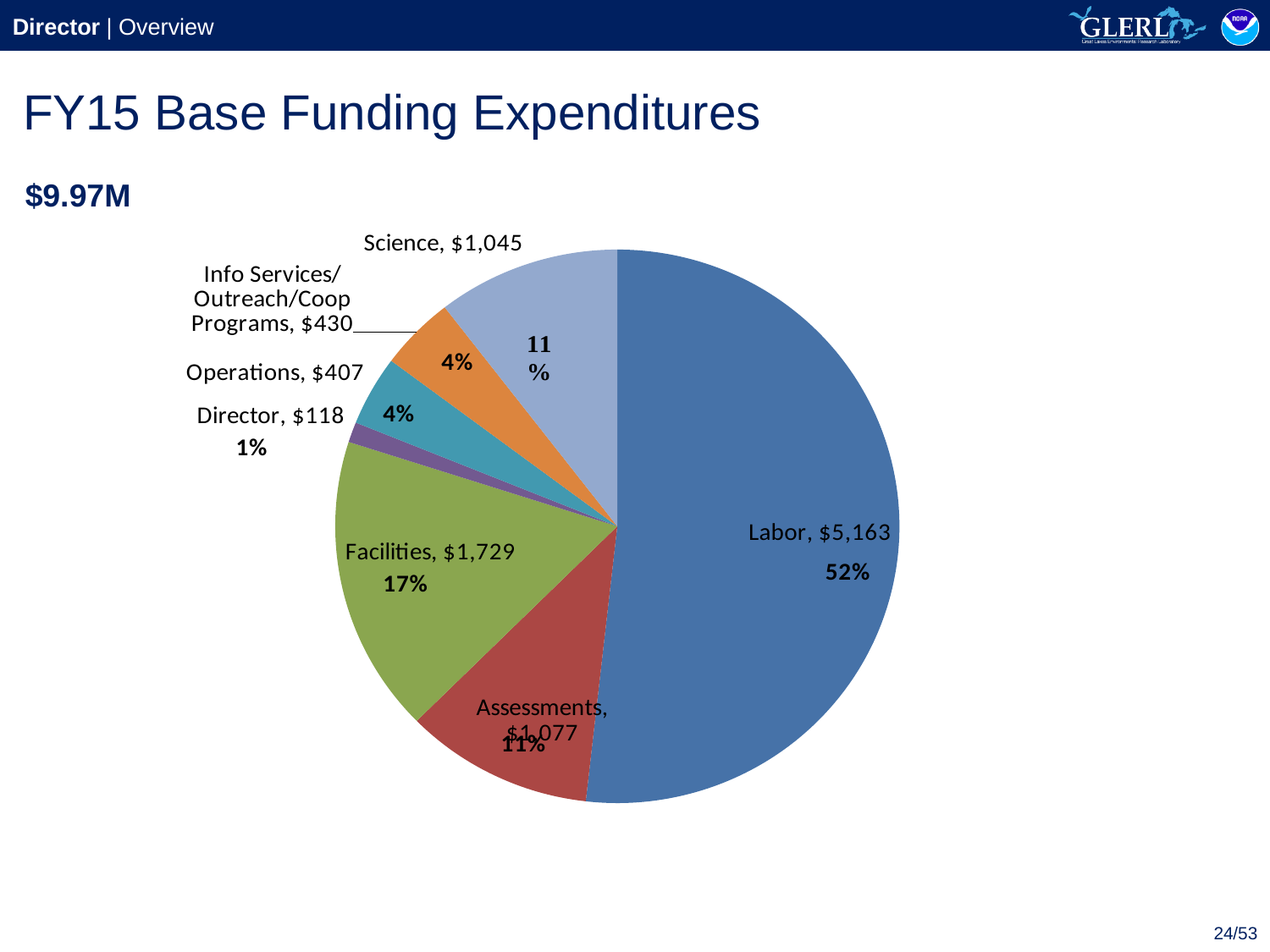
How many categories are shown in the pie chart? 7 Which is larger, the value for Operations or the value for Info Services/Outreach/Coop Programs? Info Services/Outreach/Coop Programs What is the value shown for Facilities in the pie chart? $1,729 Which category has the largest slice of the pie chart? Labor What is the difference between the Facilities value and the Assessments value? $652 What type of chart is shown on the slide? Pie chart What percentage share of the pie does Facilities represent? 17% What is the value shown for Director in the pie chart? $118 Which category has the smallest slice of the pie chart? Director What percentage share of the pie does Labor represent? 52% What is the value shown for Labor in the pie chart? $5,163 What is the value shown for Science in the pie chart? $1,045